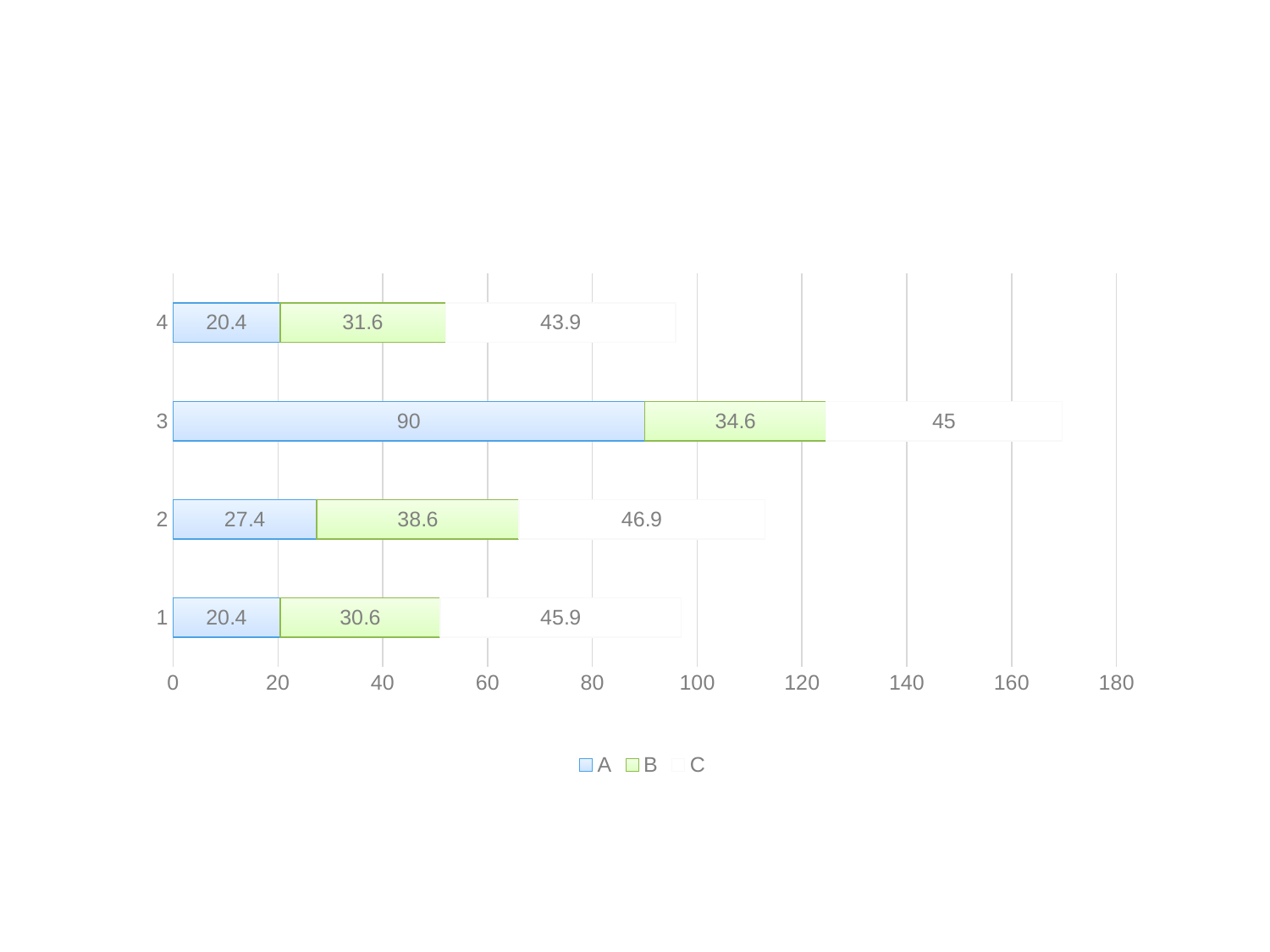
Which category has the highest value for series A? 3 How many series does the legend list? 3 What is the value of series B for category 4? 31.6 What is the value of series A for category 3? 90 How many categories are shown on the chart? 4 What kind of chart is shown on the slide? Stacked bar chart What is the value of series C for category 2? 46.9 What is the total of the stacked bar for category 1? 96.9 Which is larger: series C for category 1 or series C for category 4? Series C for category 1 Which category has the lowest value for series B? 1 What is the difference between the series A values for category 3 and category 2? 62.6 What is the total of the stacked bar for category 3? 169.6